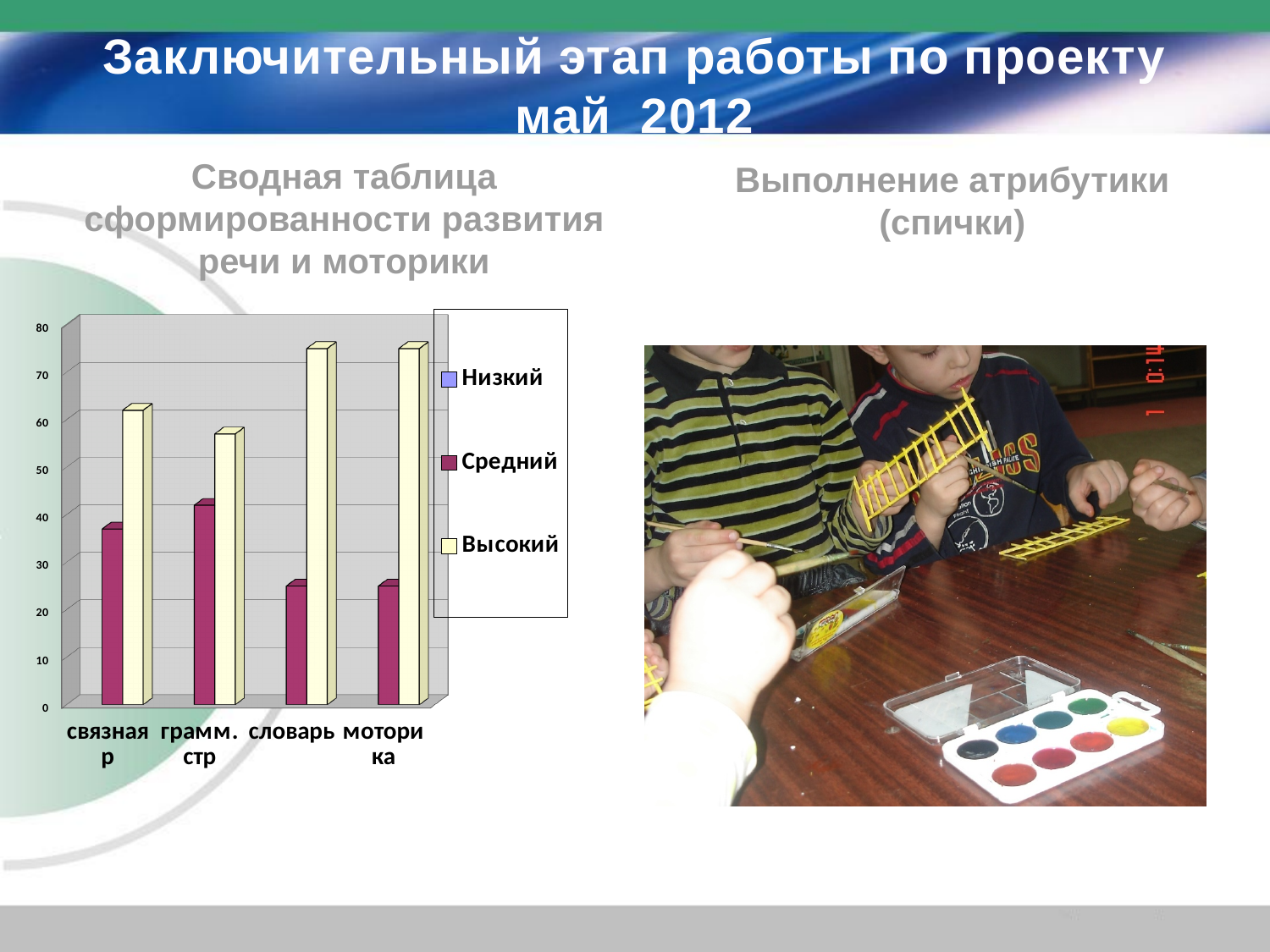
Which series are listed in the chart legend? Низкий, Средний, Высокий How many series does the chart legend list? 3 Which category has the highest Средний value? грамм. стр Which is larger for связная р, the Средний value or the Высокий value? Высокий How many categories are shown on the x axis of the chart? 4 Is the Средний value for грамм. стр greater or less than 30? greater What kind of chart is shown on the slide? bar chart Is the Высокий value for связная р greater or less than 50? greater Is the Средний value for словарь greater or less than 30? less What is the title of the chart? Сводная таблица сформированности развития речи и моторики